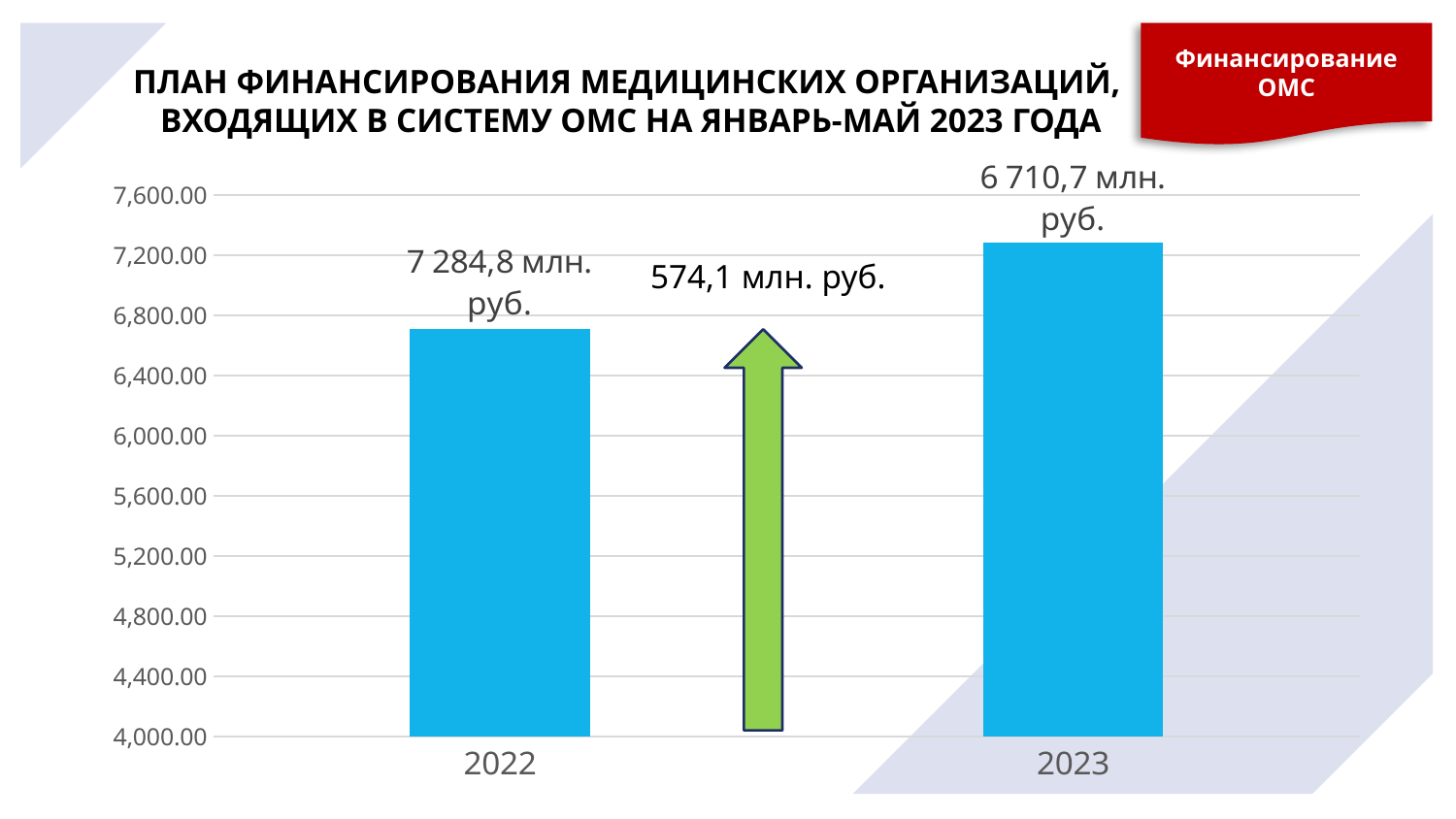
What is the lowest value shown on the vertical axis? 4,000.00 Which category has the lowest bar? 2022 Is the value of the 2022 bar greater or less than 6,400.00? greater Which year has the taller bar, 2022 or 2023? 2023 Is the value of the 2022 bar greater or less than 7,200.00? less How many bars (categories) does the chart show? 2 What is the highest value shown on the vertical axis? 7,600.00 Is the value of the 2023 bar greater or less than 7,200.00? greater Do the bar values rise or fall from 2022 to 2023? rise What kind of chart is shown on the slide? bar chart What value is printed on the green arrow between the two bars? 574,1 млн. руб. Which category has the highest bar? 2023